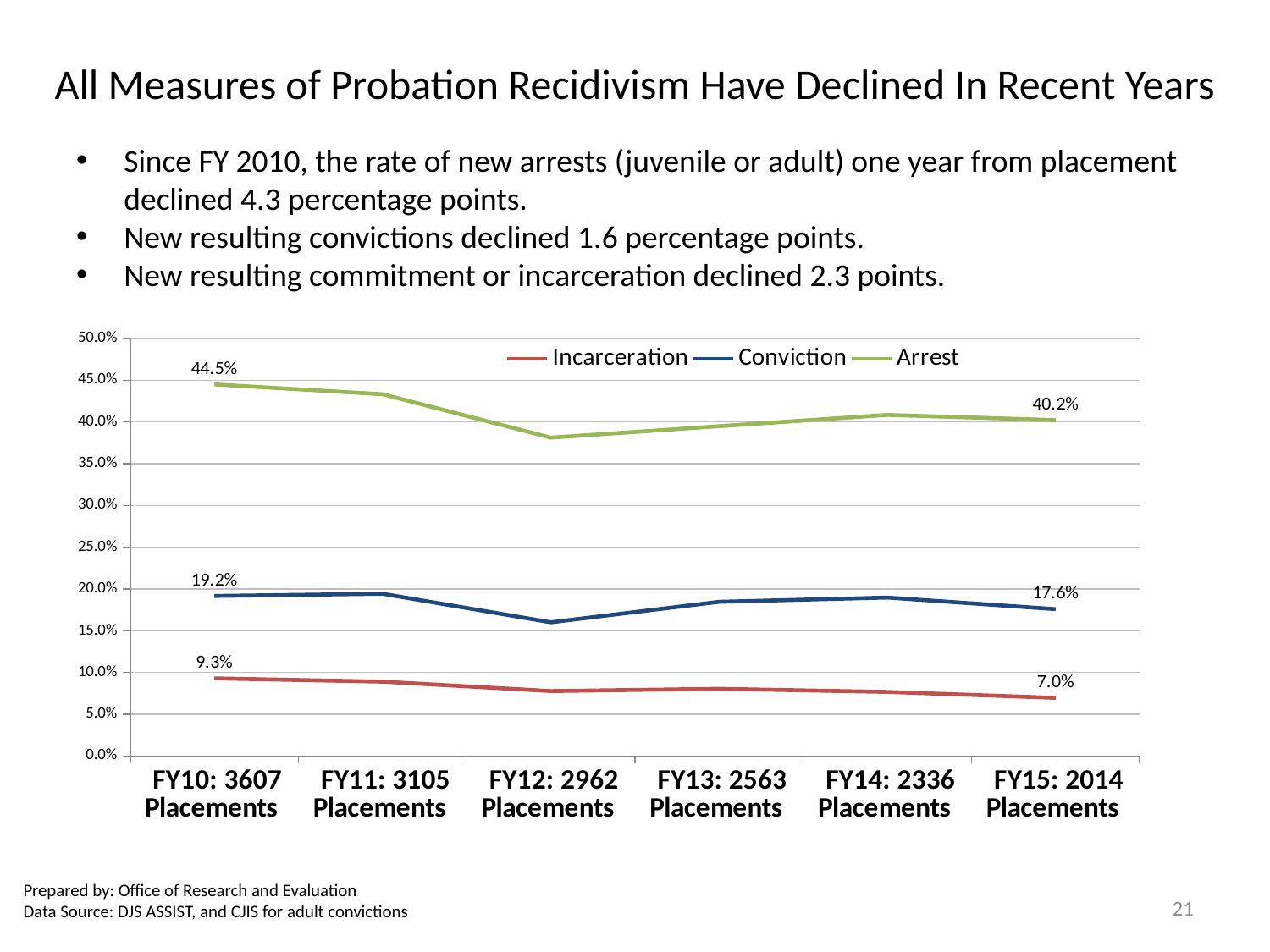
What is the Conviction rate for FY10: 3607 Placements? 19.2% What type of chart is shown on the slide? line chart What is the Arrest rate for FY15: 2014 Placements? 40.2% Does the Incarceration rate rise or fall from FY10 to FY15? fall By how many percentage points did the Conviction rate change from FY10 to FY15? 1.6 How many fiscal-year categories are plotted along the x axis? 6 Is the Arrest rate for FY12: 2962 Placements greater or less than 40.0%? less What is the Incarceration rate for FY15: 2014 Placements? 7.0% Which series has the highest values across all years? Arrest What is the Arrest rate for FY10: 3607 Placements? 44.5% How many series does the chart legend list? 3 By how many percentage points did the Incarceration rate change from FY10 to FY15? 2.3